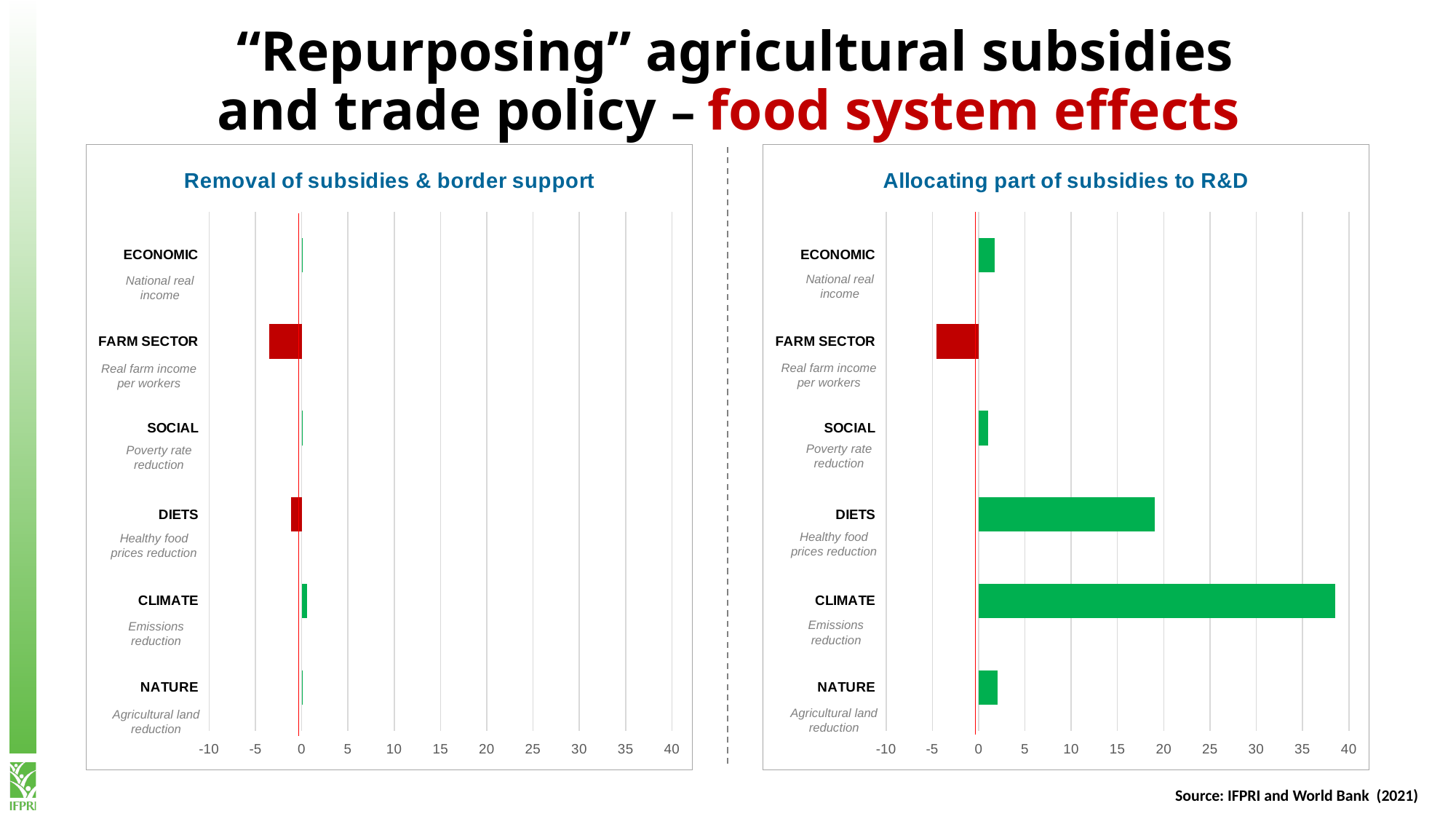
In the 'Allocating part of subsidies to R&D' chart, which category has the lowest value? FARM SECTOR In the 'Allocating part of subsidies to R&D' chart, is the value for CLIMATE greater or less than 35? greater In the 'Removal of subsidies & border support' chart, which is larger, the value for FARM SECTOR or the value for DIETS? DIETS In the 'Allocating part of subsidies to R&D' chart, is the value for DIETS greater or less than 15? greater In the 'Allocating part of subsidies to R&D' chart, is the value for FARM SECTOR greater or less than 0? less What colour are the bars with negative values in both charts? red In the 'Removal of subsidies & border support' chart, which category has the lowest value? FARM SECTOR How many categories are shown in the 'Allocating part of subsidies to R&D' chart? 6 In the 'Allocating part of subsidies to R&D' chart, which category has the highest value? CLIMATE What kind of chart is the 'Removal of subsidies & border support' chart? bar chart In the 'Allocating part of subsidies to R&D' chart, which is larger, the value for DIETS or the value for CLIMATE? CLIMATE